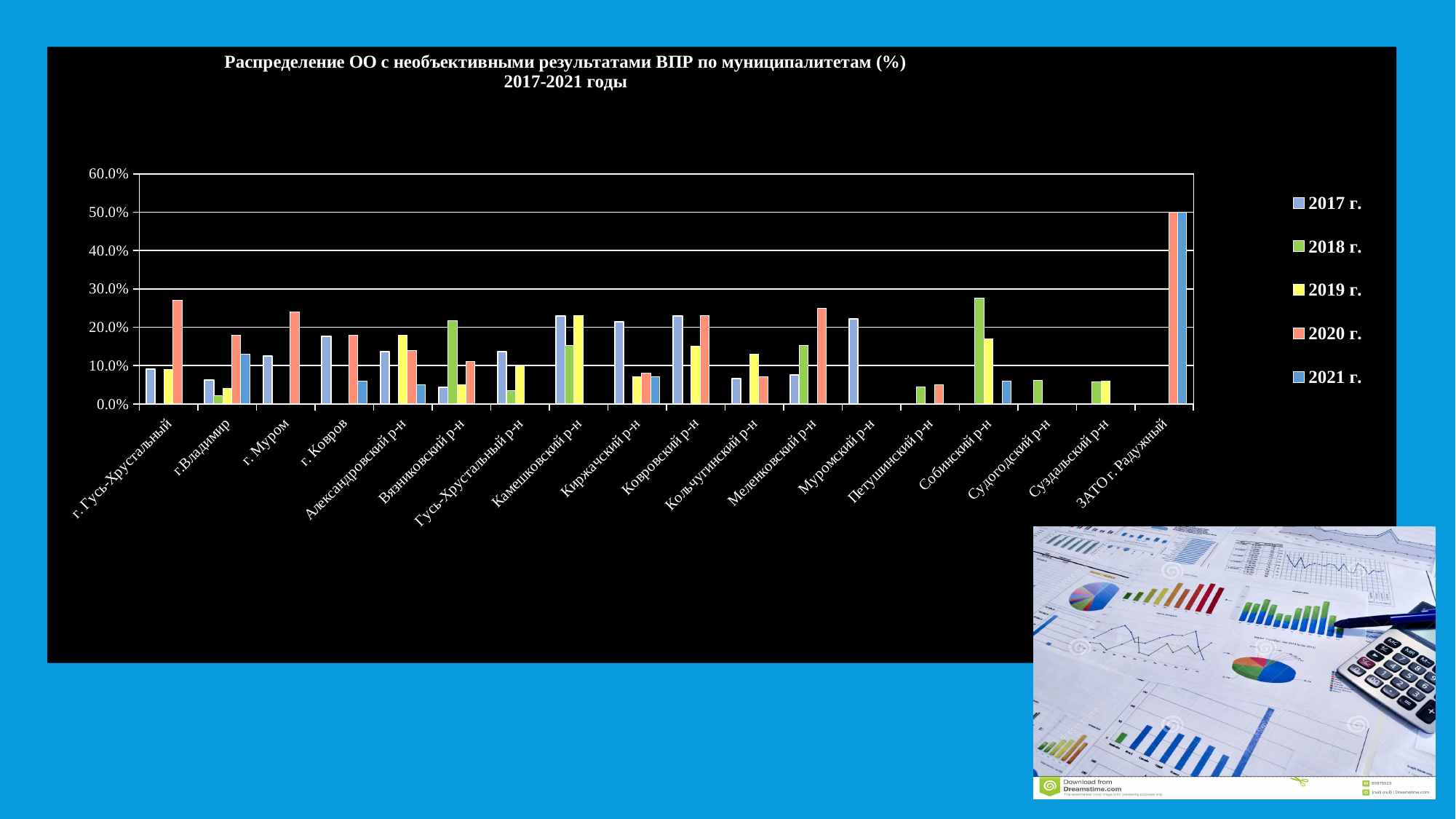
How many municipalities are shown along the x axis? 18 For Ковровский р-н, which year has the larger value: 2017 г. or 2019 г.? 2017 г. How many series does the legend list? 5 Is the 2020 г. value for ЗАТО г. Радужный greater or less than 40.0%? greater For Меленковский р-н, which year has the larger value: 2017 г. or 2020 г.? 2020 г. Is the 2017 г. value for Муромский р-н greater or less than 10.0%? greater What kind of chart is shown on the slide? bar chart Which year range is given in the chart title? 2017-2021 годы Is the 2020 г. value for г. Гусь-Хрустальный greater or less than 20.0%? greater For г. Муром, which year has the larger value: 2017 г. or 2020 г.? 2020 г. Which municipality has the tallest bar in the chart? ЗАТО г. Радужный